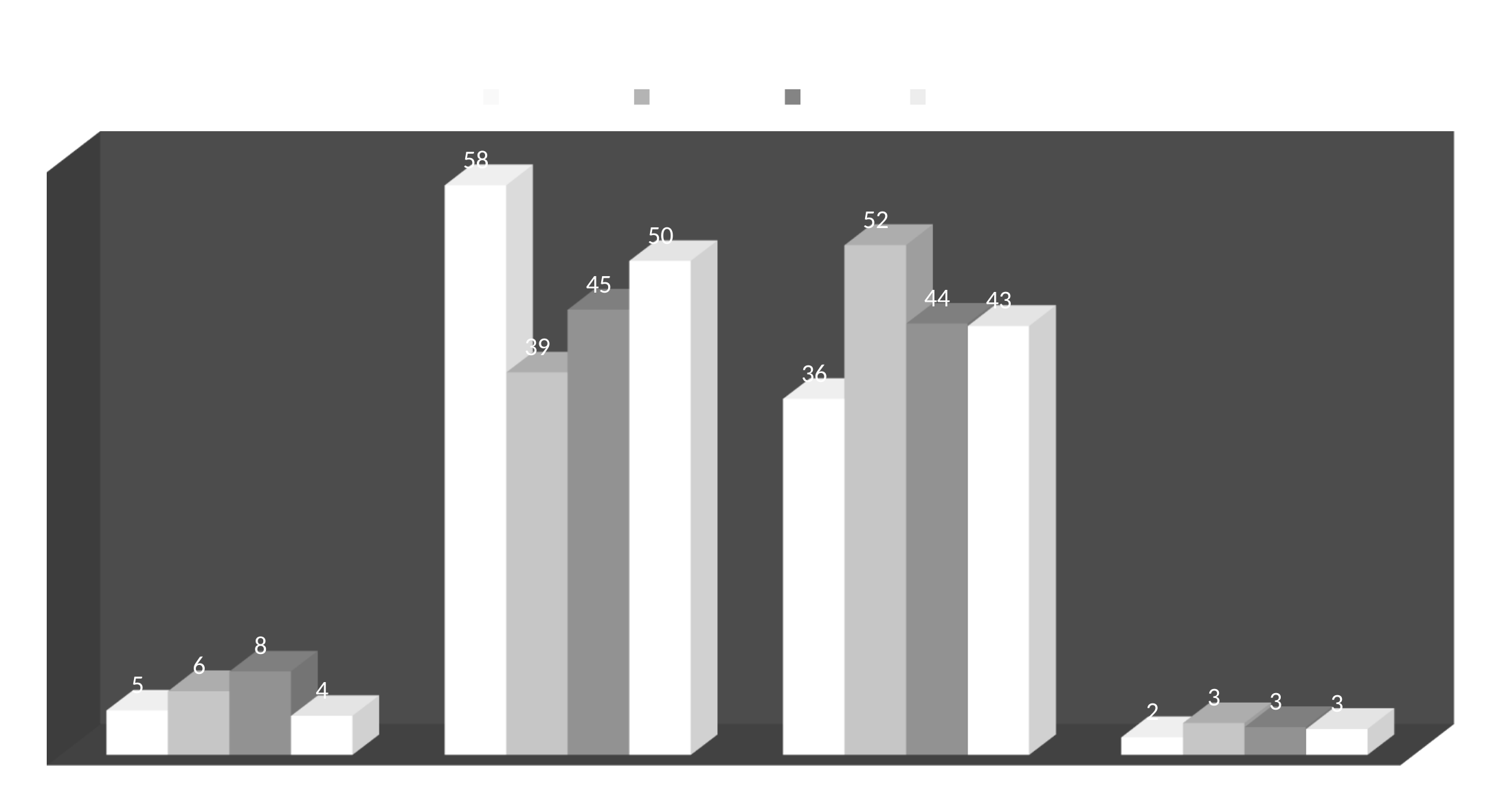
What is the highest value shown on the chart? 58 What is the value of the third bar in the first group from the left? 8 What is the value of the second bar in the third group from the left? 52 What kind of chart is shown on the slide? bar chart How many groups of bars are plotted along the x axis? 4 What is the lowest value shown on the chart? 2 What is the value of the first (leftmost) bar in the second group from the left? 58 Which group of bars contains the tallest bar on the chart? the second group from the left What is the difference between the second bar (52) and the first bar (36) in the third group from the left? 16 In the third group from the left, which is larger: the first bar or the second bar? the second bar (52) What is the difference between the first bar (58) and the second bar (39) in the second group from the left? 19 How many series does the legend show? 4